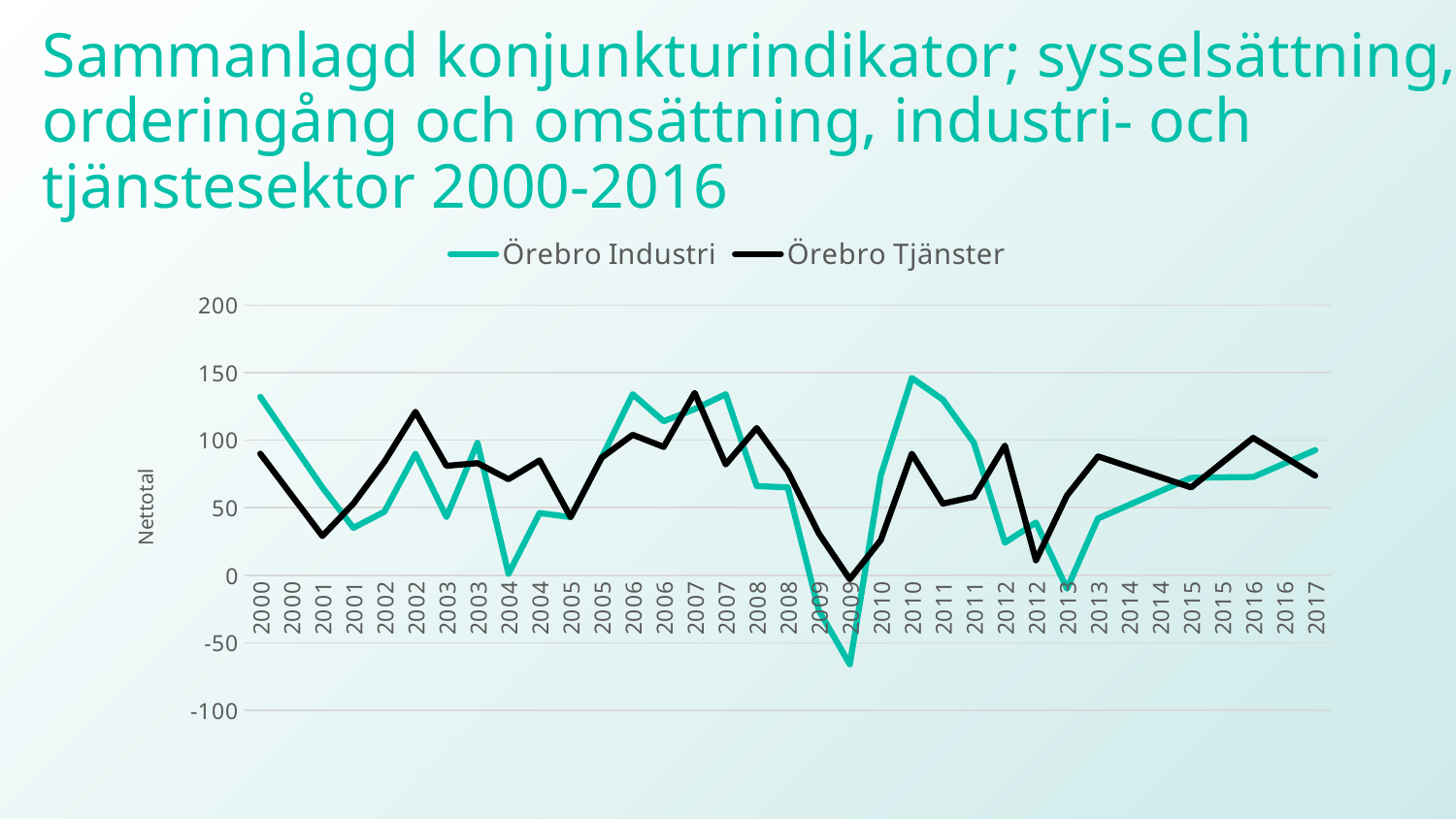
How many series does the legend list? 2 What are the two series named in the legend? Örebro Industri and Örebro Tjänster Is the value for Örebro Industri at the first 2010 point greater or less than 100? less Is the value for Örebro Tjänster at the first 2001 point greater or less than 50? less Is the value for Örebro Industri at the second 2009 point greater or less than -50? less Does the Örebro Industri line rise or fall from the first 2013 point to 2017? rise What is the label on the vertical axis? Nettotal At the first 2010 point, which series has the larger value, Örebro Industri or Örebro Tjänster? Örebro Industri What kind of chart is shown on the slide? line chart How many points are plotted along the x axis for each series? 35 Which series reaches the lowest value anywhere on the chart? Örebro Industri